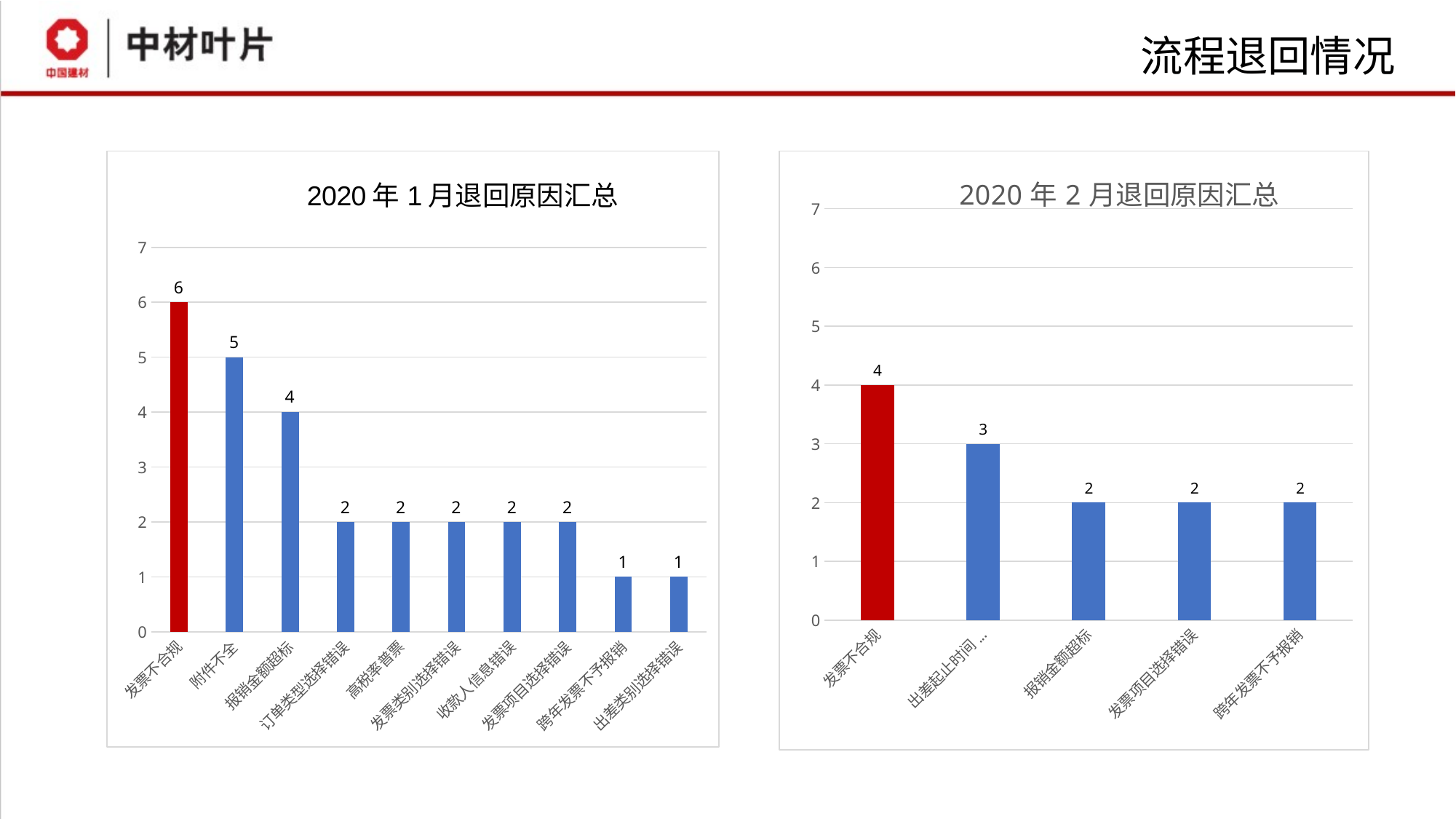
In the chart titled 2020年1月退回原因汇总, what is the difference between the values for 发票不合规 and 报销金额超标? 2 What kind of chart is the chart titled 2020年2月退回原因汇总? bar chart In the chart titled 2020年1月退回原因汇总, how many categories are shown on the x axis? 10 In the chart titled 2020年1月退回原因汇总, what is the value for 发票不合规? 6 In the chart titled 2020年1月退回原因汇总, which is larger, the value for 附件不全 or the value for 高税率普票? 附件不全 In the chart titled 2020年2月退回原因汇总, what is the value for 发票不合规? 4 In the chart titled 2020年2月退回原因汇总, what is the value for 报销金额超标? 2 In the chart titled 2020年1月退回原因汇总, which category has the highest value? 发票不合规 In the chart titled 2020年1月退回原因汇总, what is the value for 附件不全? 5 In the chart titled 2020年2月退回原因汇总, what is the difference between the values for 发票不合规 and 跨年发票不予报销? 2 In the chart titled 2020年1月退回原因汇总, what colour is the bar for 发票不合规? red In the chart titled 2020年2月退回原因汇总, how many categories are shown on the x axis? 5